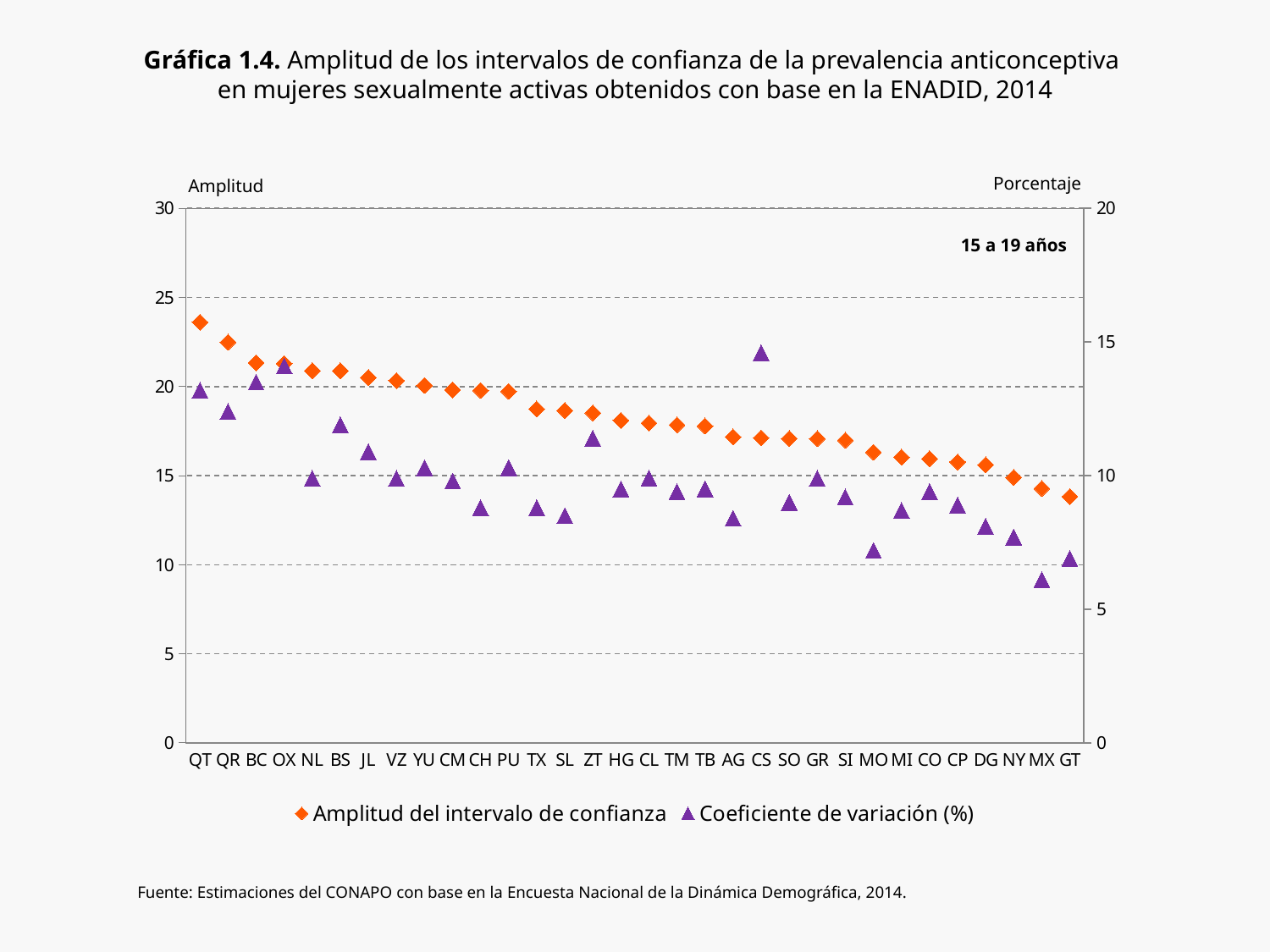
Which category has the lowest value for Amplitud del intervalo de confianza? GT Which category has the highest value for Coeficiente de variación (%)? CS Which category has the highest value for Amplitud del intervalo de confianza? QT What kind of chart is shown on the slide? scatter chart How many categories (state abbreviations) are shown on the x axis? 32 Which age group does the chart refer to, according to the label inside the plot area? 15 a 19 años Is the Amplitud del intervalo de confianza value for GT greater or less than 15 on the left axis? less Is the Amplitud del intervalo de confianza value for QT greater or less than 20 on the left axis? greater How many series does the legend list? 2 Which category has the lowest value for Coeficiente de variación (%)? MX Do the Amplitud del intervalo de confianza values rise or fall from left to right along the x axis? fall Is the Coeficiente de variación (%) value for CS greater or less than 10 on the right axis? greater